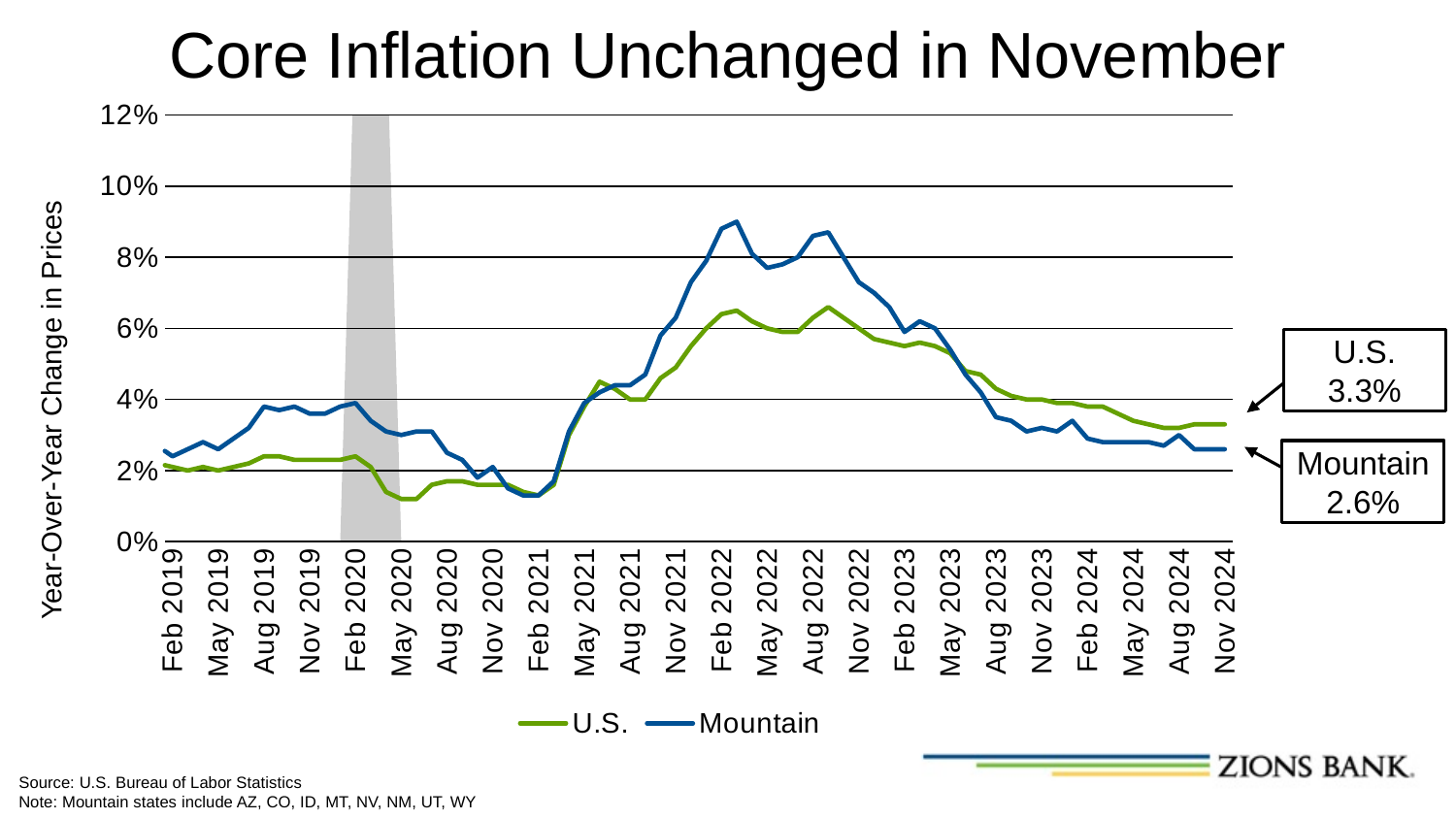
Is the Mountain value in Aug 2019 greater or less than 3%? greater What is the labeled Mountain core inflation value for November 2024? 2.6% What is the title of the chart? Core Inflation Unchanged in November What is the labeled U.S. core inflation value for November 2024? 3.3% What kind of chart is shown on the slide? Line chart How many series does the legend list? 2 Is the U.S. value in May 2020 greater or less than 2%? less Is the Mountain value in Feb 2022 greater or less than 8%? greater Which series reaches the higher peak over the whole period, U.S. or Mountain? Mountain From Aug 2022 to Nov 2024, does the U.S. line generally rise or fall? fall In November 2024, which series has the higher value, U.S. or Mountain? U.S. What is the difference between the U.S. and Mountain values labeled for November 2024? 0.7 percentage points